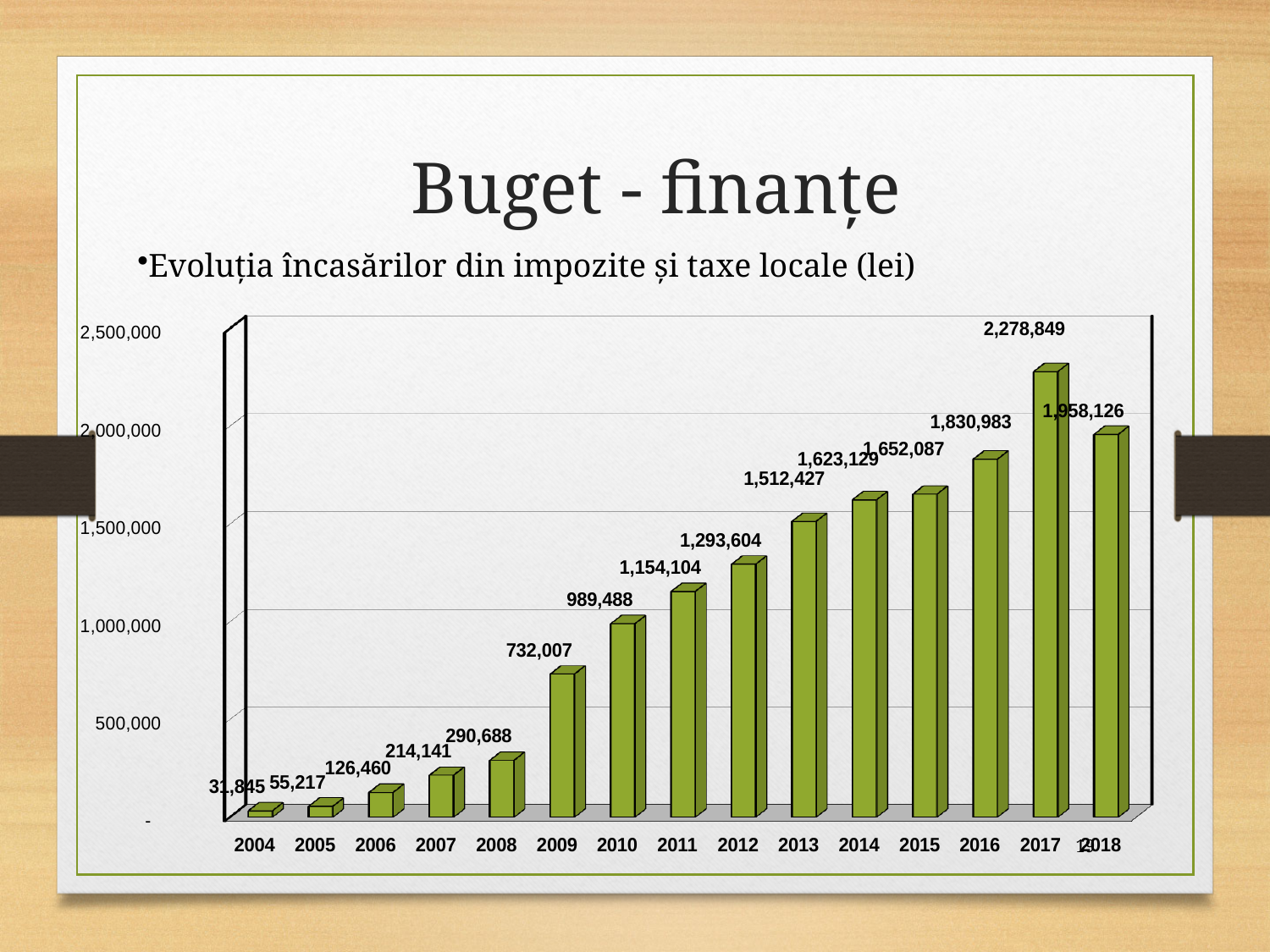
What is the value for 2018? 1,958,126 Which year has the lowest value? 2004 What is the value for 2009? 732,007 What is the difference between the values for 2010 and 2009? 257,481 What is the value for 2017? 2,278,849 How many years are shown on the x axis? 15 What is the value for 2006? 126,460 What is the difference between the values for 2017 and 2018? 320,723 Which is larger, the value for 2016 or the value for 2018? 2018 Is the value for 2016 greater or less than 2,000,000? less Which year has the highest value? 2017 What kind of chart is shown on the slide? bar chart